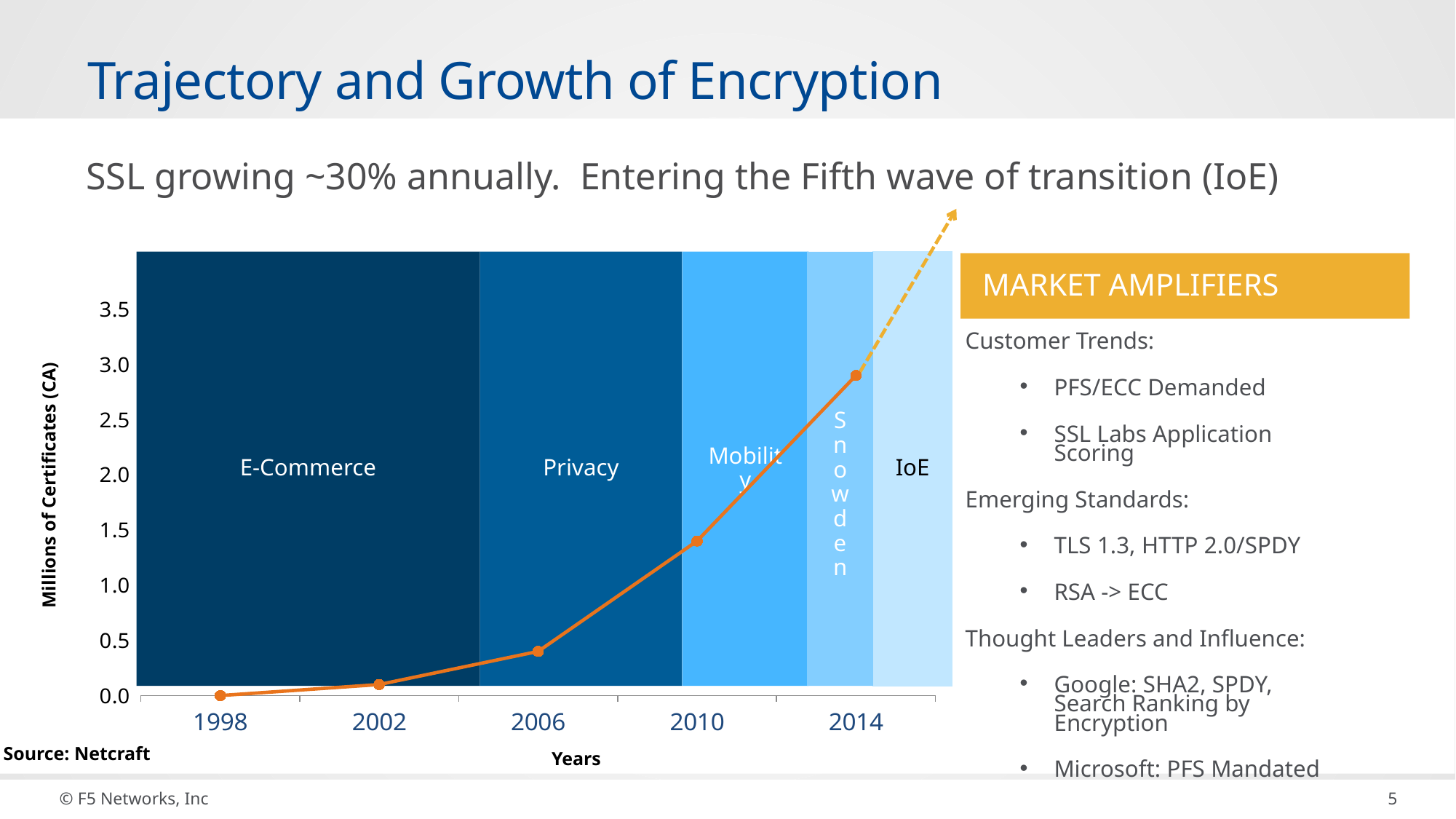
Do the values rise or fall from 1998 to 2014? rise Is the value for 2014 greater or less than 2.5? greater Which year has the highest number of certificates? 2014 How many data points are plotted on the line? 5 Is the value for 2010 greater or less than 1.0? greater Is the value for 2006 greater or less than 0.5? less What kind of chart is shown on the slide? line chart What is the source cited for the chart data? Netcraft Which year has the lowest number of certificates? 1998 Which is larger, the value for 2010 or the value for 2006? 2010 What is the label on the y axis of the chart? Millions of Certificates (CA)